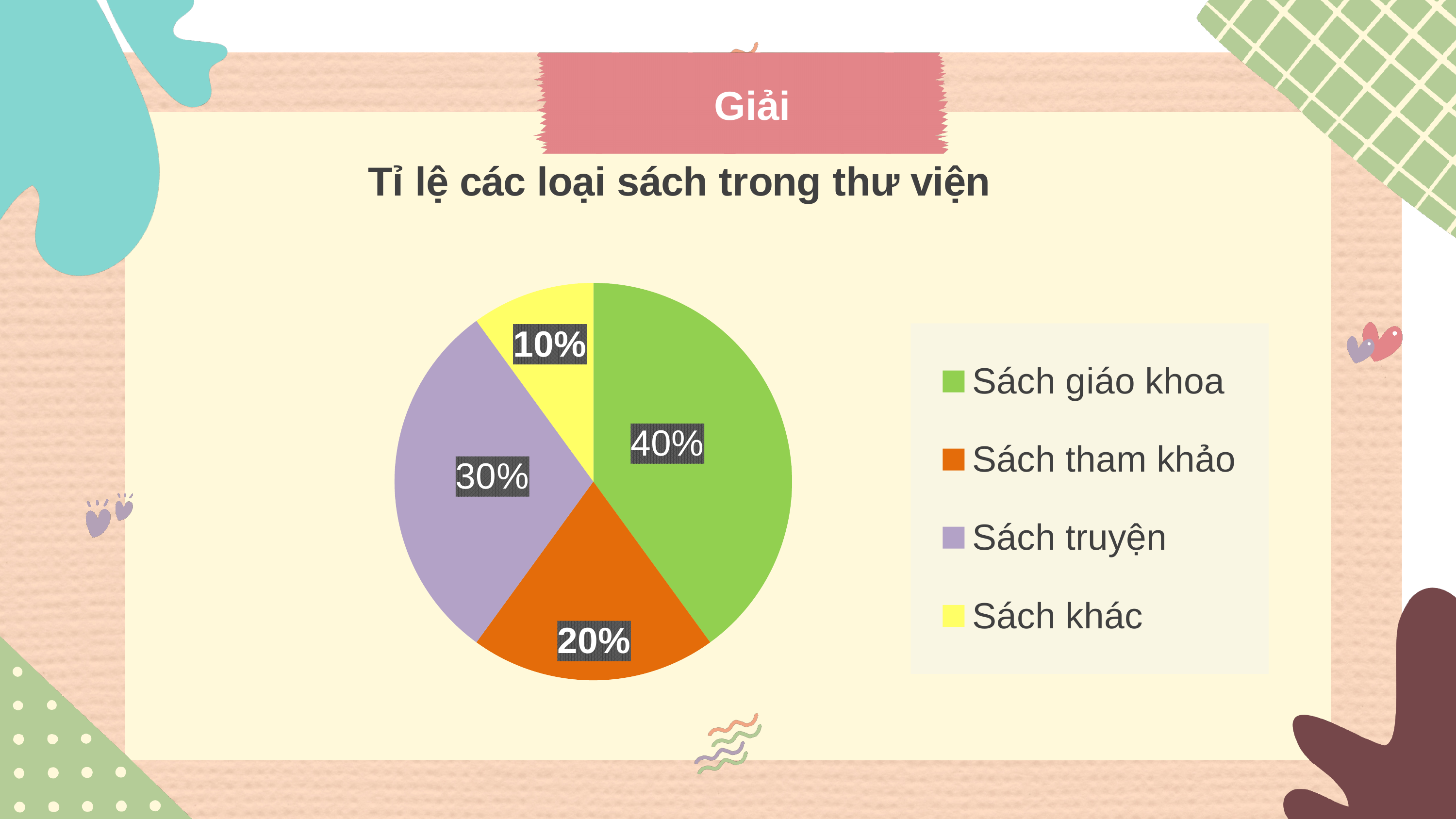
How many categories does the pie chart have? 4 What percentage of the pie is Sách khác? 10% What percentage of the pie is Sách giáo khoa? 40% Which category has the largest share of the pie? Sách giáo khoa What is the difference between the shares of Sách giáo khoa and Sách tham khảo? 20% Which category has the smallest share of the pie? Sách khác What colour is the slice for Sách truyện? purple What percentage of the pie is Sách tham khảo? 20% What is the title of the chart? Tỉ lệ các loại sách trong thư viện Which has a larger share, Sách truyện or Sách tham khảo? Sách truyện What kind of chart is shown on the slide? pie chart What percentage of the pie is Sách truyện? 30%